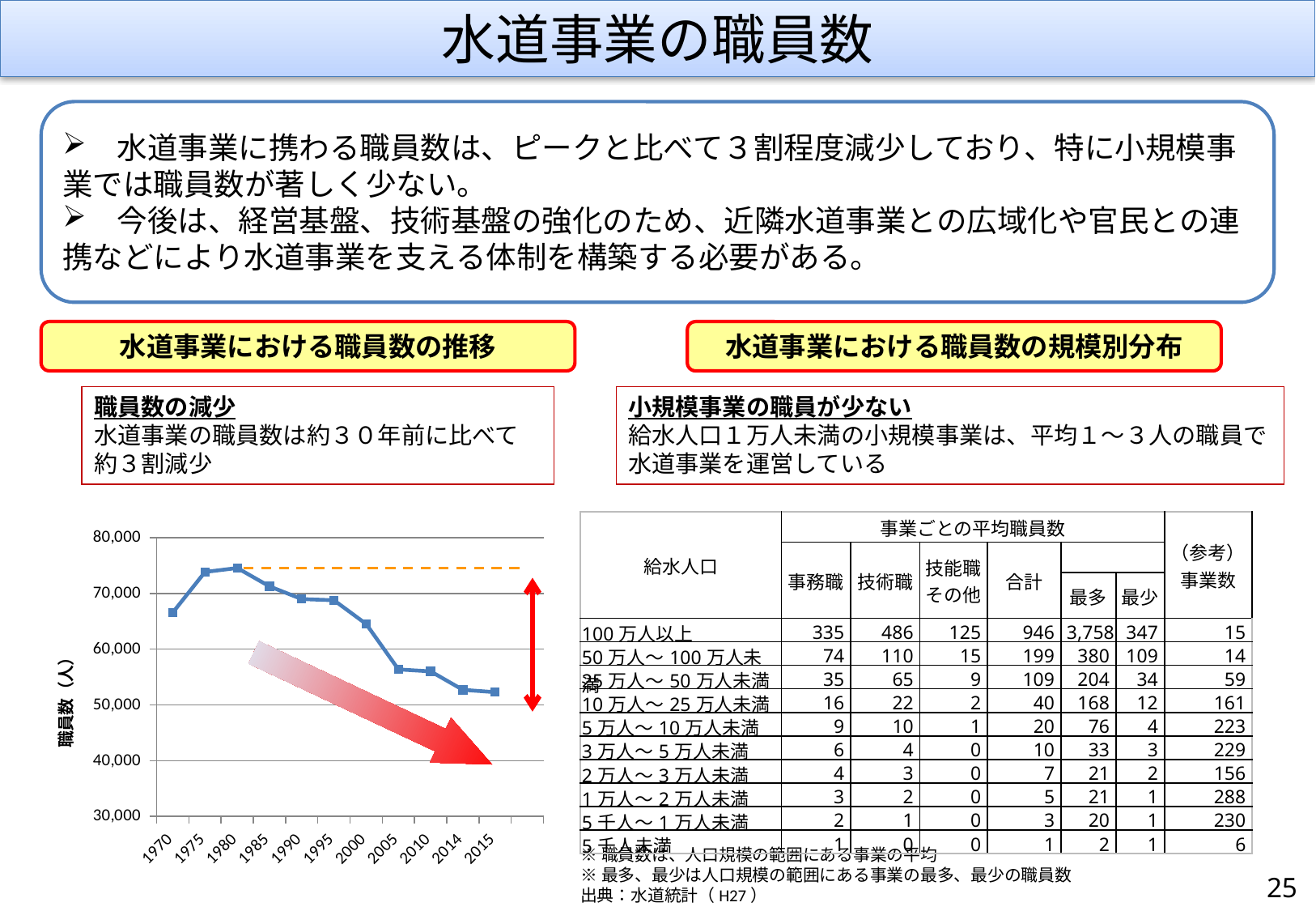
In the line chart, which year has the larger value, 1970 or 2015? 1970 In the line chart, is the value for 1980 greater or less than 70,000? greater Overall, do the values in the line chart rise or fall from 1980 to 2015? fall What is the title shown above the line chart? 水道事業における職員数の推移 In the line chart, is the value for 2000 greater or less than 60,000? greater In the line chart, which year has the larger value, 1990 or 2005? 1990 What is the label on the y axis of the line chart? 職員数（人） In the line chart, is the value for 1970 greater or less than 60,000? greater What kind of chart is shown on the left side of the slide under 水道事業における職員数の推移? line chart How many years are plotted on the x axis of the line chart? 11